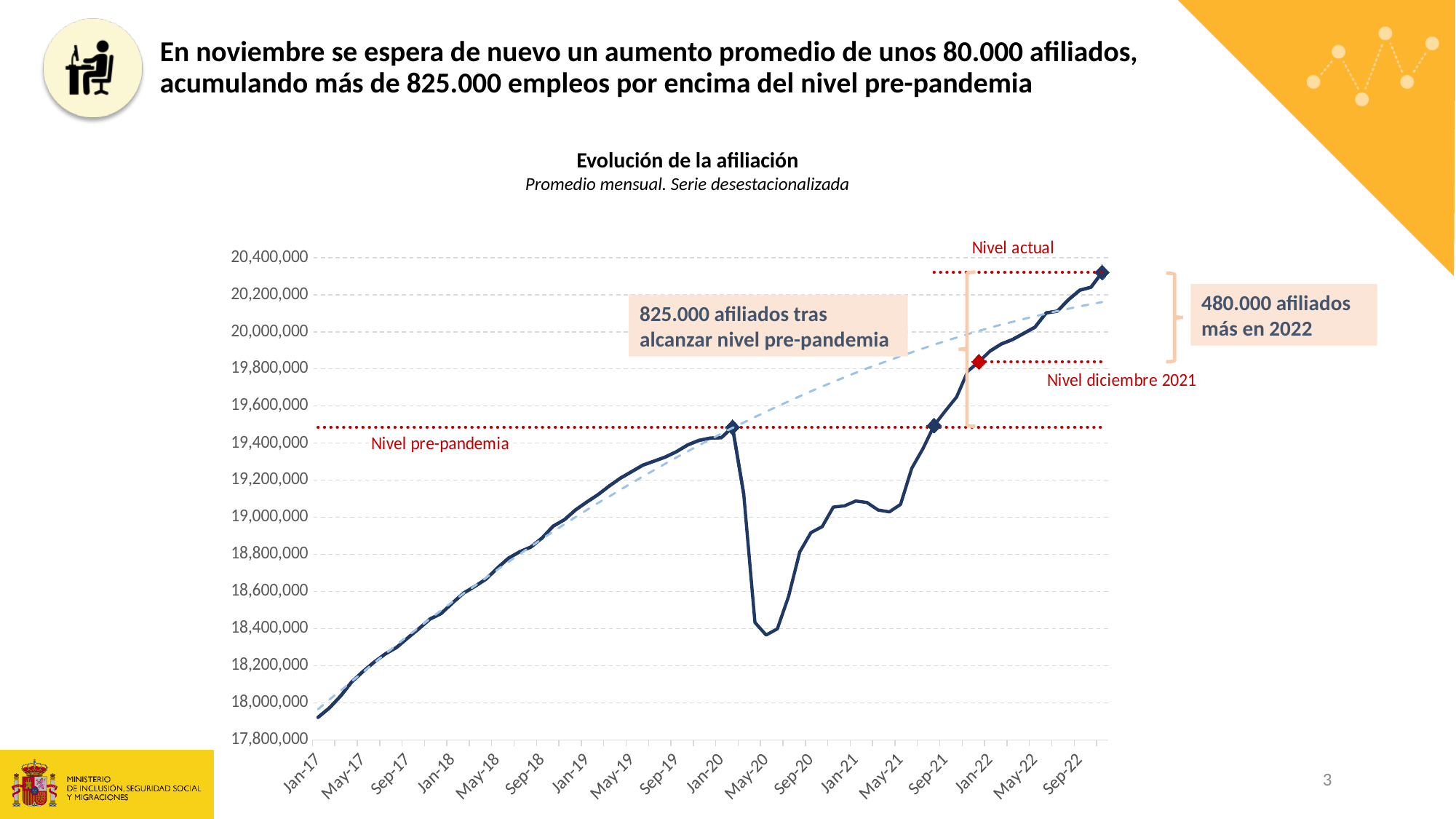
What is the title of the chart? Evolución de la afiliación Is the value for Sep-19 greater or less than 19,200,000? greater Is the value for May-20 greater or less than 18,600,000? less Which is larger, the value for Jan-20 or the value for May-20? Jan-20 What kind of chart is shown on the slide? line chart Is the value for Jan-17 greater or less than 18,000,000? less Overall, do the values of the solid line rise or fall from Jan-17 to Sep-22? rise What is the subtitle shown under the chart title? Promedio mensual. Serie desestacionalizada At which x-axis label does the solid line reach its lowest value? Jan-17 Which is larger, the value for Sep-21 or the value for Jan-21? Sep-21